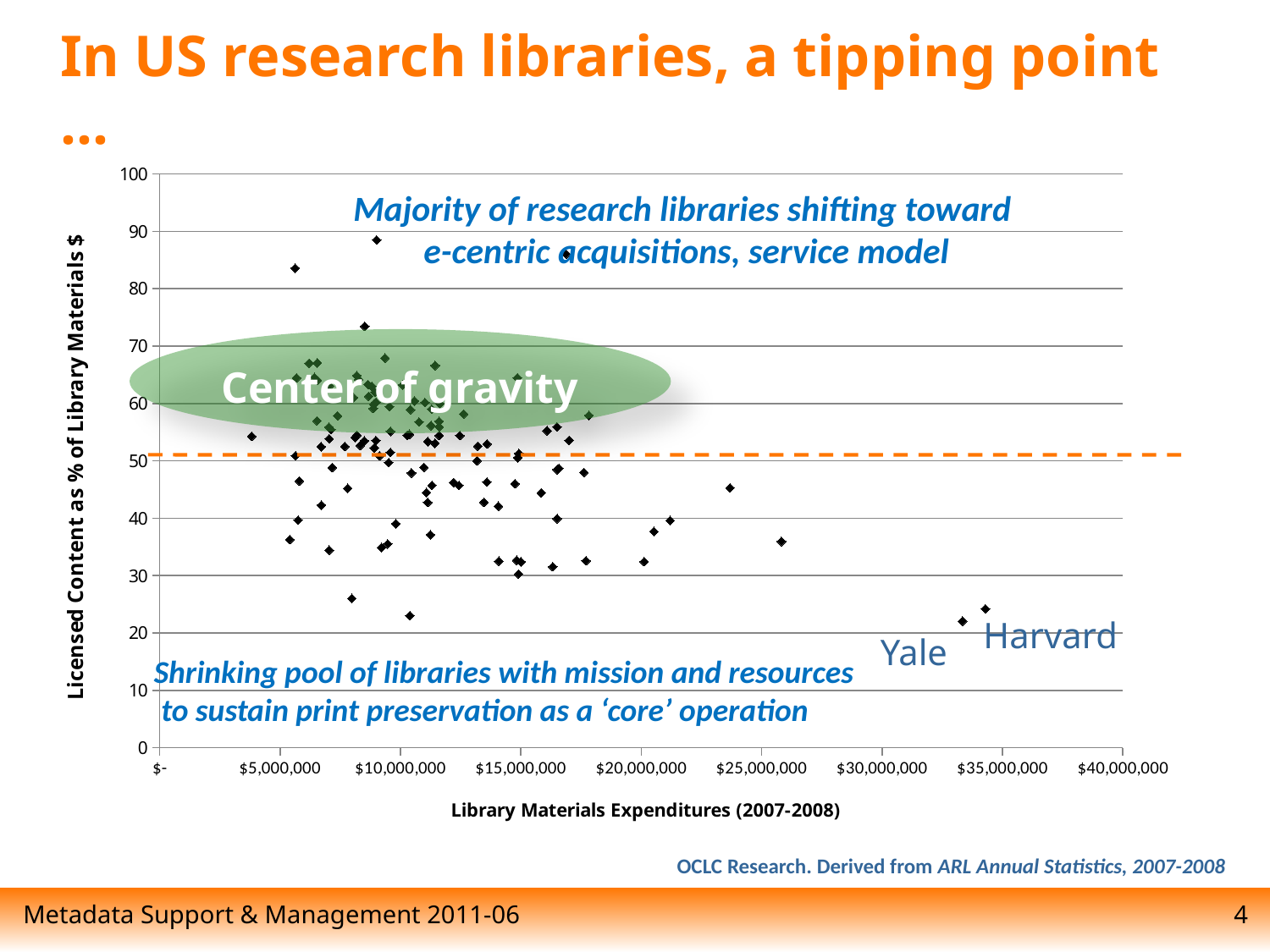
Which has the higher library materials expenditure, Yale or Harvard? Harvard What is the maximum value shown on the y axis of the chart? 100 What is the title of the y axis of the chart? Licensed Content as % of Library Materials $ Is the licensed content percentage for Harvard greater or less than 30? less Is the highest plotted licensed content percentage greater or less than 80? greater Is the licensed content percentage for Yale greater or less than 30? less What kind of chart is shown on the slide? scatter plot What is the title of the x axis of the chart? Library Materials Expenditures (2007-2008)